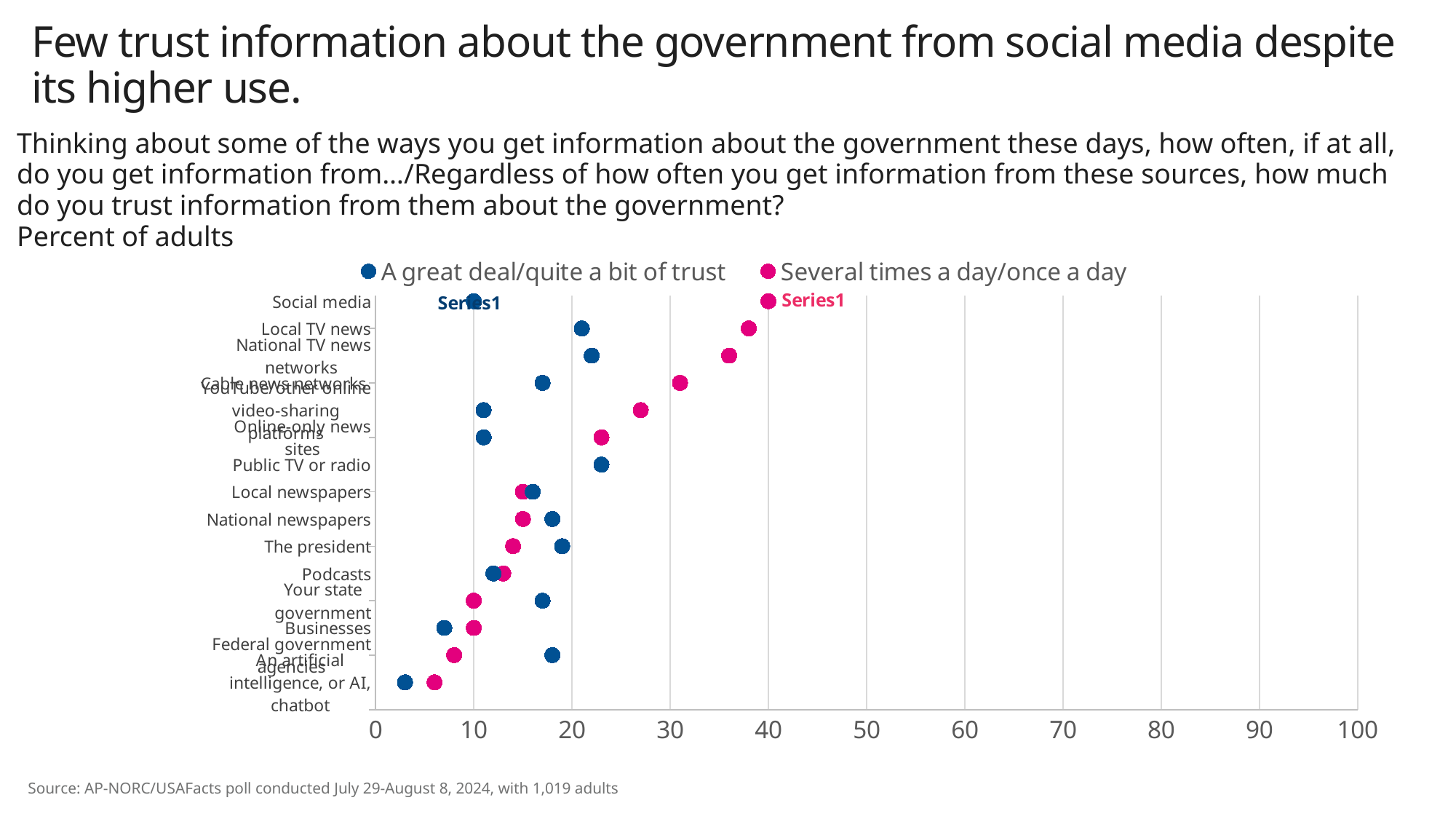
Is the 'A great deal/quite a bit of trust' value for An artificial intelligence, or AI, chatbot greater or less than 10? less Which source has the highest value for 'Several times a day/once a day'? Social media Which source has the lowest value for 'A great deal/quite a bit of trust'? An artificial intelligence, or AI, chatbot How many information sources (categories) are plotted on the y axis? 15 For The president, which is larger: the 'A great deal/quite a bit of trust' value or the 'Several times a day/once a day' value? A great deal/quite a bit of trust For Social media, which is larger: the 'A great deal/quite a bit of trust' value or the 'Several times a day/once a day' value? Several times a day/once a day Is the 'Several times a day/once a day' value for Cable news networks greater or less than 20? greater Which colour represents 'Several times a day/once a day' in the legend? pink What kind of chart is shown on the slide? dot plot Is the 'Several times a day/once a day' value for Social media greater or less than 30? greater How many series does the legend list? 2